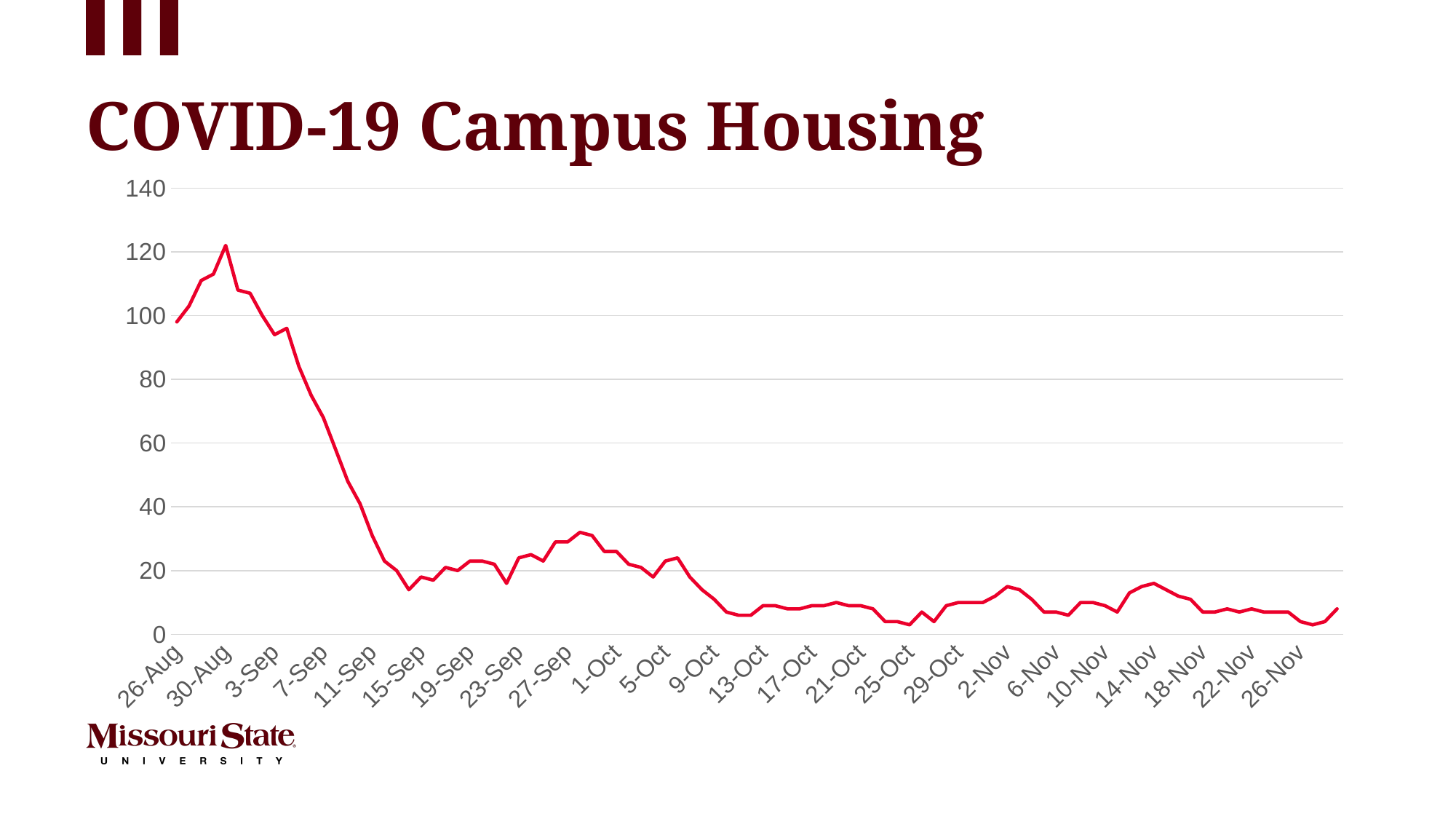
What kind of chart is shown on the slide? line chart Is the value at 26-Nov greater or less than 20? less Is the value at 3-Sep greater or less than 100? less What is the title of the chart? COVID-19 Campus Housing Does the line rise or fall between 30-Aug and 15-Sep? fall Which is larger, the value at 26-Aug or the value at 26-Nov? 26-Aug What colour is the line in the chart? red Is the value at 27-Sep greater or less than 40? less Around which date label does the line reach its highest value? 30-Aug